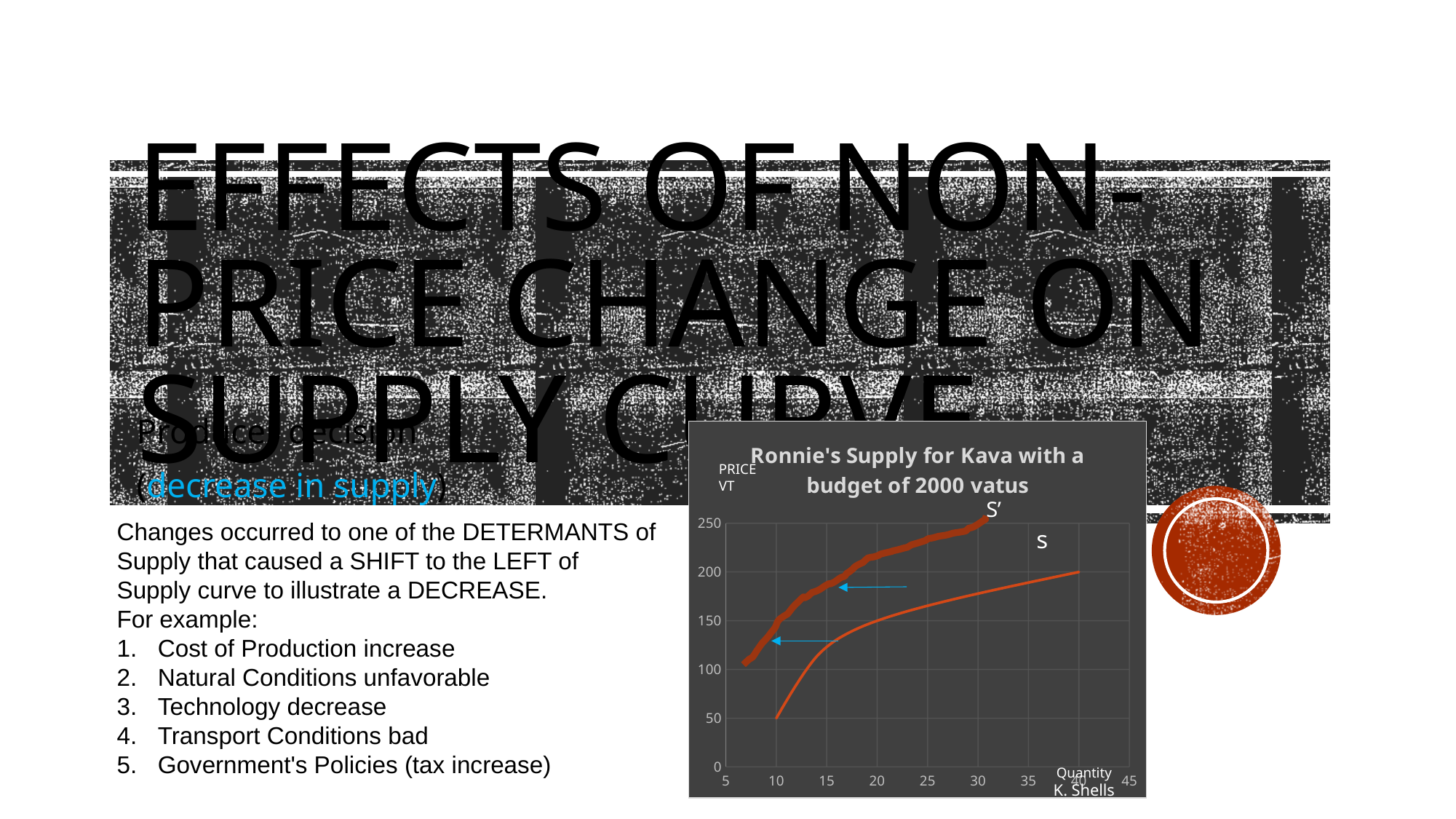
What is the highest value shown on the vertical axis? 250 How many supply curves are plotted on the chart? 2 What is the label of the vertical axis of the chart? PRICE VT Is the price on curve S at a quantity of 35 greater or less than 200? less What kind of chart is shown on the slide? line chart Is the price on curve S' at a quantity of 15 greater or less than 150? greater Do the values of curve S rise or fall as quantity increases? rise What is the title of the chart? Ronnie's Supply for Kava with a budget of 2000 vatus Is the price on curve S' at a quantity of 20 greater or less than 200? greater At a quantity of 20, which curve shows the higher price, S or S'? S'